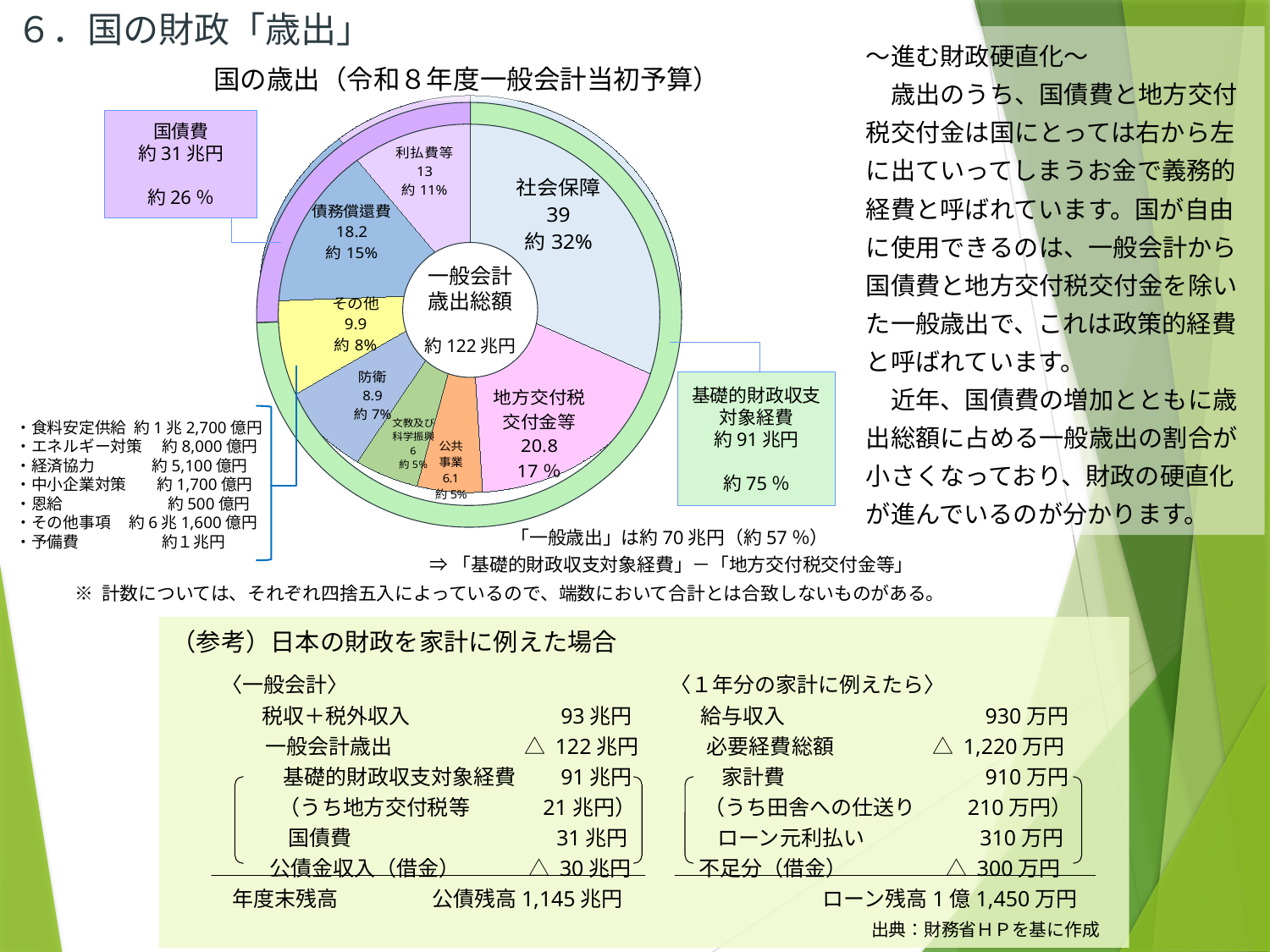
How many slices does the pie chart have? 8 What total is shown in the centre of the pie chart for 一般会計歳出総額? 約 122 兆円 Which is larger in the pie chart, 防衛 or その他? その他 What share of the pie does 社会保障 represent? 約 32% What kind of chart is used to show 国の歳出（令和８年度一般会計当初予算）? pie chart What value is shown for 社会保障 in the pie chart? 39 Which slice of the pie chart is the largest? 社会保障 What is the difference between the values for 債務償還費 and 利払費等? 5.2 What is the difference between the values for 社会保障 and 地方交付税交付金等? 18.2 What is the title of the chart? 国の歳出（令和８年度一般会計当初予算） What share of the pie does 地方交付税交付金等 represent? 17 % What value is shown for 防衛 in the pie chart? 8.9